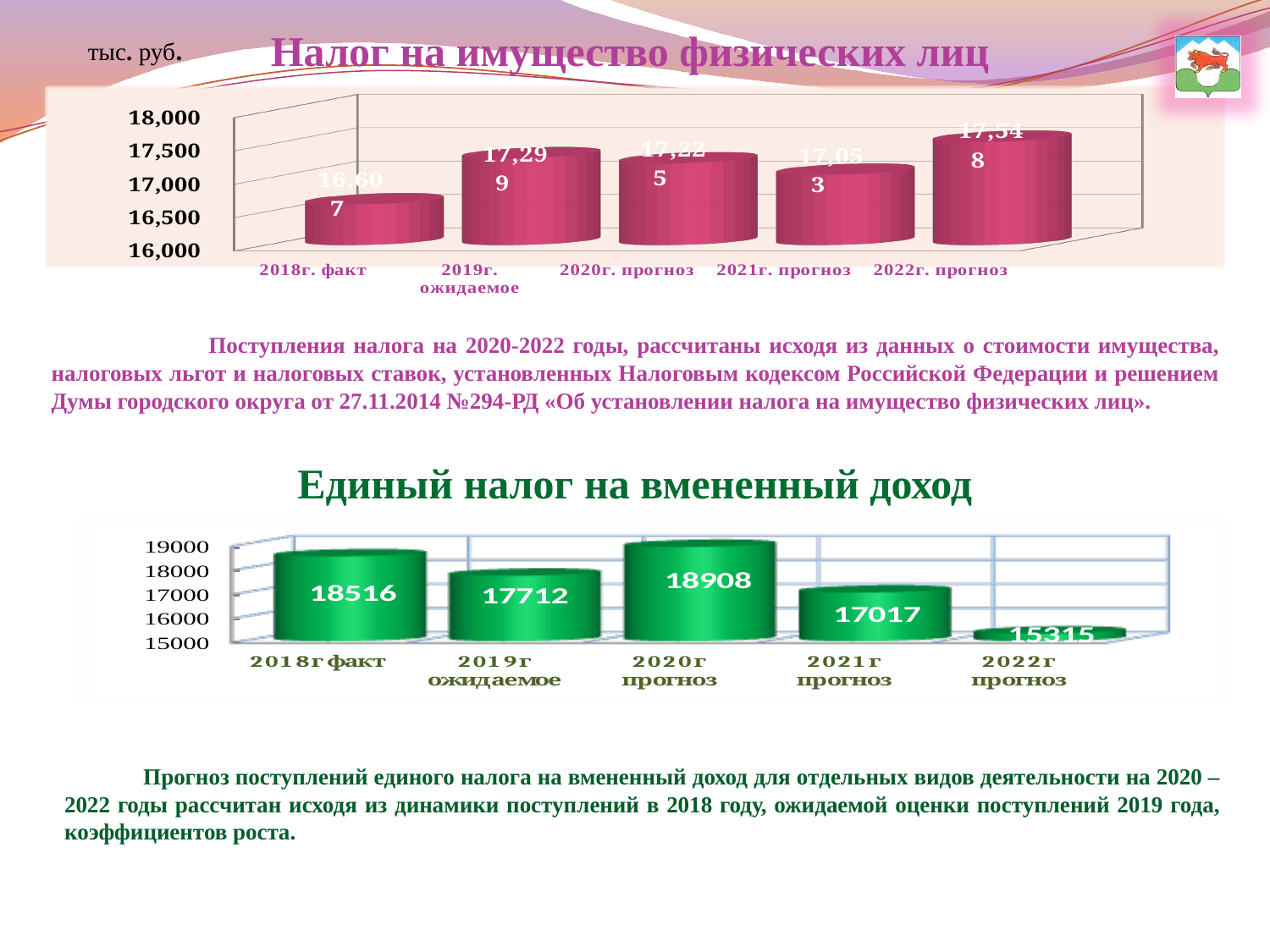
On the chart 'Налог на имущество физических лиц', what is the value for 2022г. прогноз? 17,548 What kind of chart is 'Налог на имущество физических лиц'? bar chart On the chart 'Единый налог на вмененный доход', how many categories are shown on the x axis? 5 On the chart 'Единый налог на вмененный доход', which is larger: the value for 2019г ожидаемое or the value for 2021г прогноз? 2019г ожидаемое On the chart 'Налог на имущество физических лиц', is the value for 2018г. факт greater or less than 17,000? less On the chart 'Единый налог на вмененный доход', what is the value for 2018г факт? 18516 On the chart 'Единый налог на вмененный доход', what is the value for 2022г прогноз? 15315 On the chart 'Единый налог на вмененный доход', which category has the lowest value? 2022г прогноз On the chart 'Единый налог на вмененный доход', what is the difference between the values for 2020г прогноз and 2021г прогноз? 1891 On the chart 'Налог на имущество физических лиц', which category has the lowest value? 2018г. факт On the chart 'Единый налог на вмененный доход', which category has the highest value? 2020г прогноз On the chart 'Единый налог на вмененный доход', what is the value for 2020г прогноз? 18908